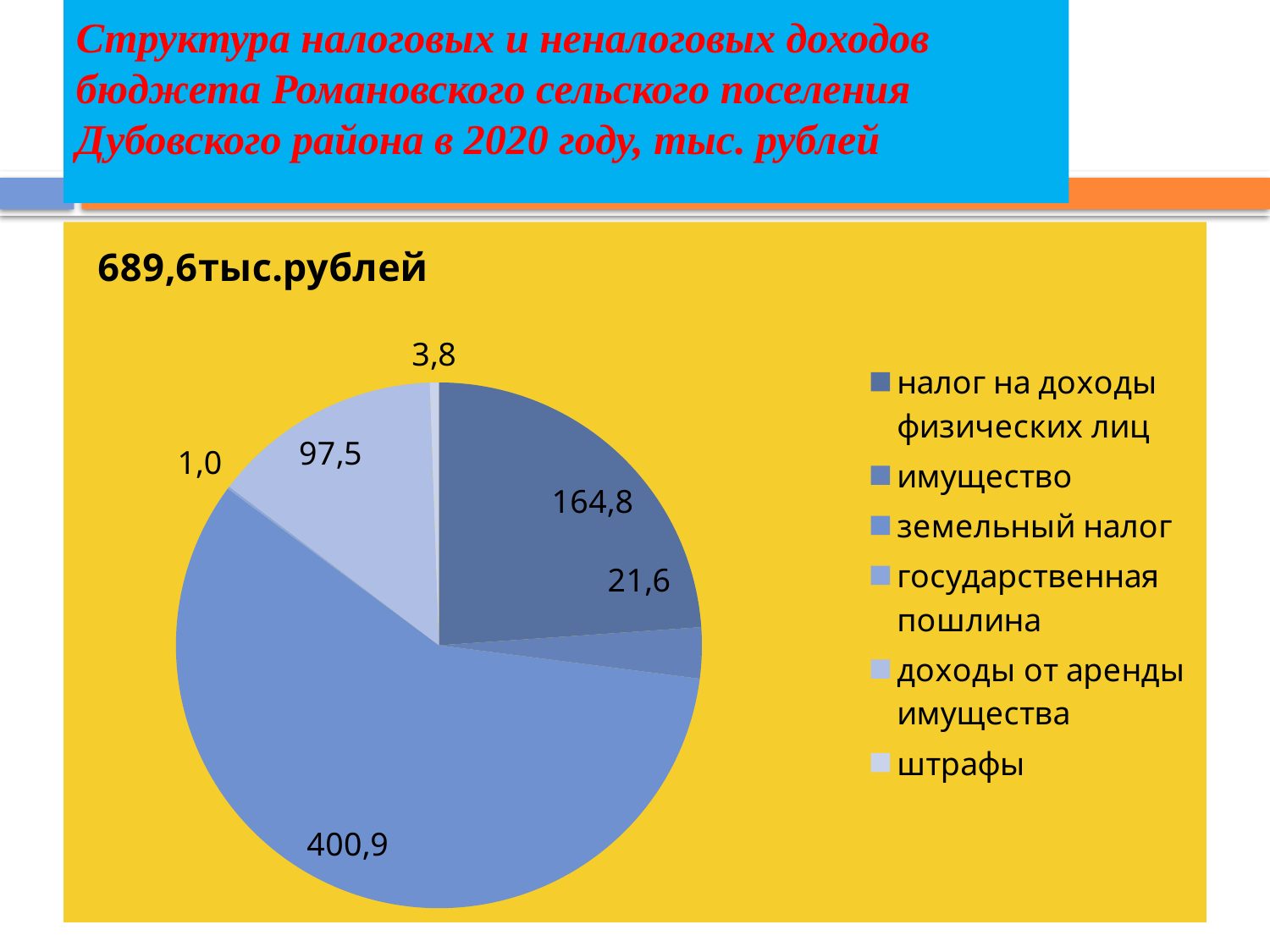
What is the value for государственная пошлина? 1,0 What is the value for штрафы? 3,8 What is the value for земельный налог? 400,9 How many categories does the legend list? 6 What is the value for имущество? 21,6 What is the difference between the values for земельный налог and налог на доходы физических лиц? 236,1 What type of chart is shown on the slide? pie chart What is the title shown above the pie chart? 689,6тыс.рублей Which category has the smallest slice of the pie? государственная пошлина Which is larger, the value for государственная пошлина or the value for имущество? имущество Which category has the largest slice of the pie? земельный налог What is the value for налог на доходы физических лиц? 164,8